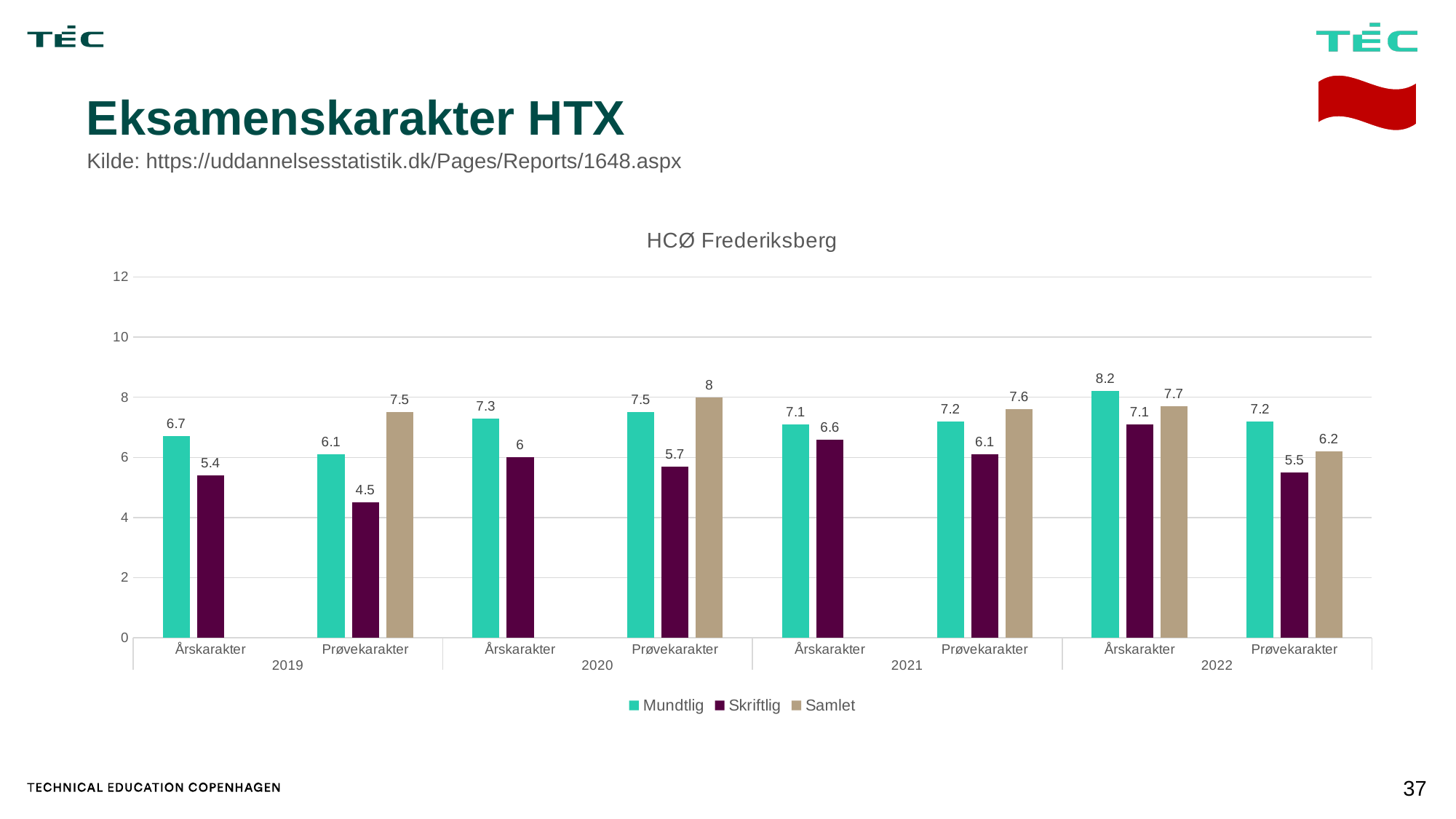
What is the difference between the Mundtlig and Skriftlig values for Årskarakter in 2022? 1.1 Is the Skriftlig value for Prøvekarakter in 2019 greater or less than 6? less What is the title of the chart? HCØ Frederiksberg Which year's Årskarakter has the highest Mundtlig value? 2022 How many series does the legend list? 3 What is the Skriftlig value for Prøvekarakter in 2022? 5.5 What is the Mundtlig value for Årskarakter in 2019? 6.7 What kind of chart is shown on the slide? Bar chart Does the Samlet value for Prøvekarakter rise or fall from 2019 to 2020? Rise Which is larger, the Samlet value for Prøvekarakter in 2021 or in 2022? 2021 Which category has the lowest Skriftlig value? Prøvekarakter 2019 What is the Samlet value for Prøvekarakter in 2020? 8